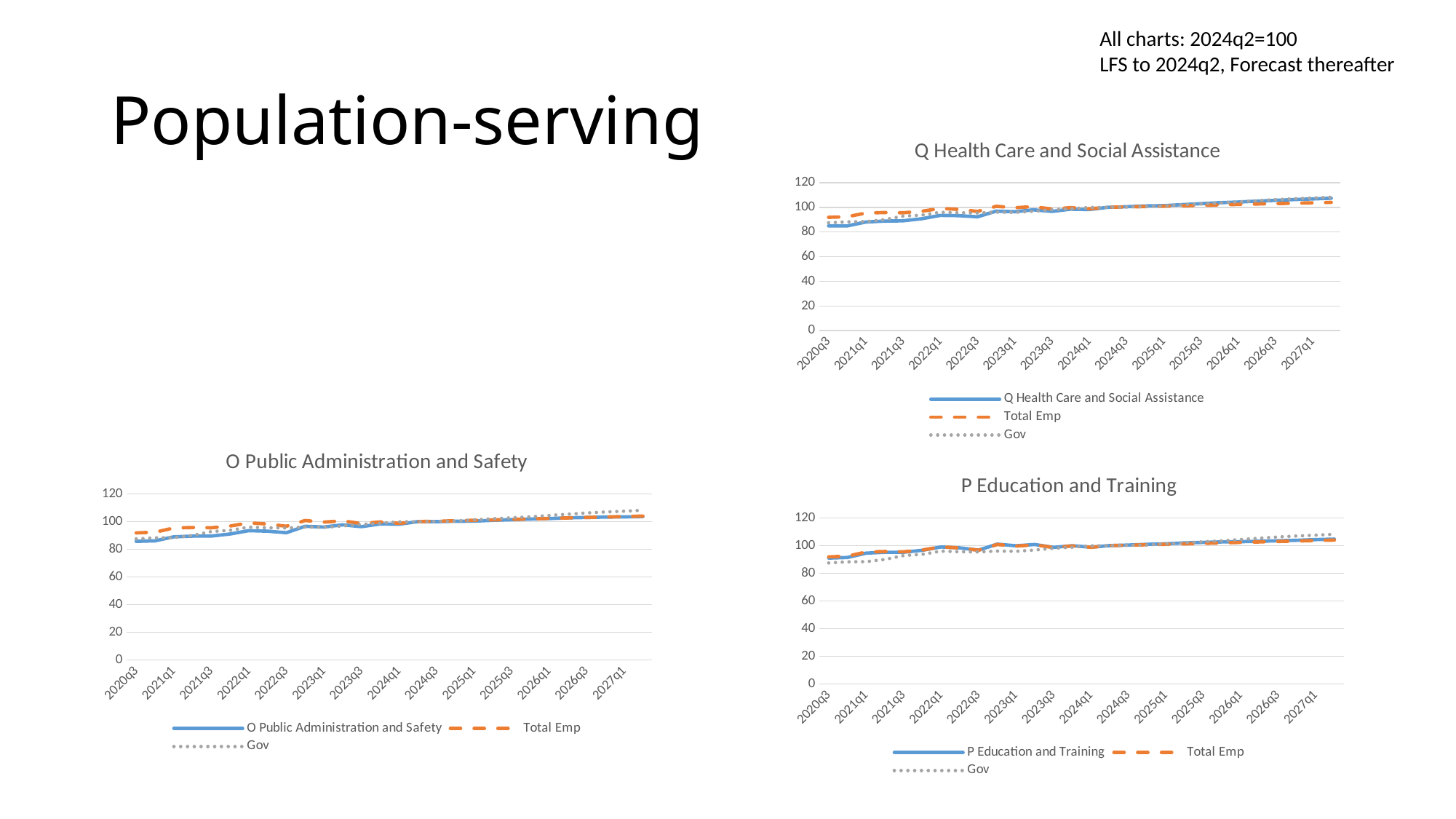
How many series does the legend of the "P Education and Training" chart list? 3 In the "Q Health Care and Social Assistance" chart, is the value of the Q Health Care and Social Assistance line at 2020q3 greater or less than 100? less In the "O Public Administration and Safety" chart, does the Gov line rise or fall across the x axis? rise How many series does the legend of the "O Public Administration and Safety" chart list? 3 In the "Q Health Care and Social Assistance" chart, which series is drawn as an orange dashed line? Total Emp In the "P Education and Training" chart, is the value of the Gov line at 2020q3 greater or less than 100? less What is the title of the chart in the bottom-left of the slide? O Public Administration and Safety In the "Q Health Care and Social Assistance" chart, does the Q Health Care and Social Assistance line rise or fall from 2020q3 to 2027q1? rise In the "P Education and Training" chart, is the value of the Gov line at 2027q1 greater or less than 100? greater What kind of chart is the "Q Health Care and Social Assistance" chart? line chart